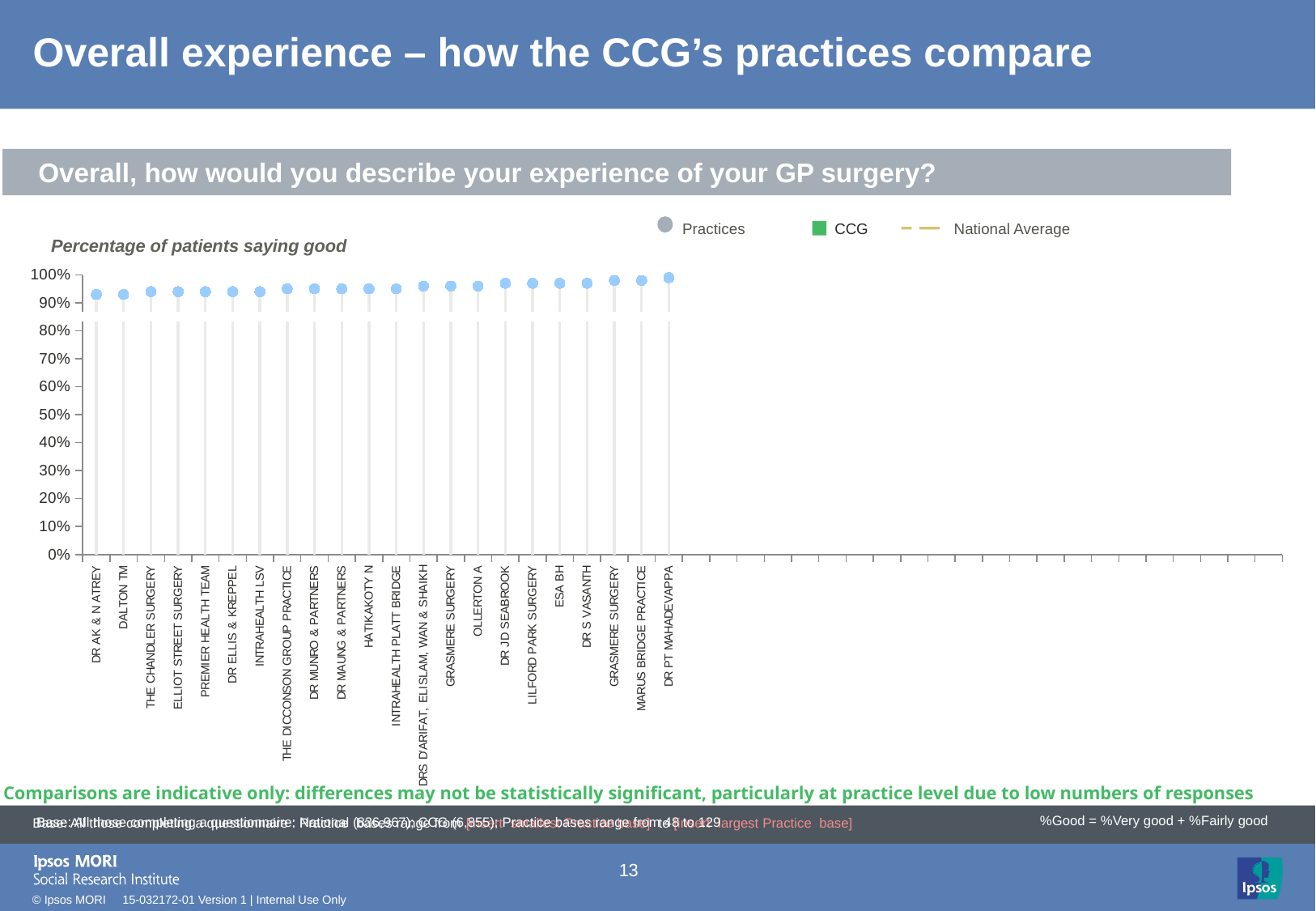
Is the value for DR AK & N ATREY greater or less than 90%? greater What is the title printed above the chart's y axis? Percentage of patients saying good Is the value for DR PT MAHADEVAPPA greater or less than 90%? greater Which has the larger value, DR PT MAHADEVAPPA or DR AK & N ATREY? DR PT MAHADEVAPPA How many entries does the chart legend list? 3 Is the value for ELLIOT STREET SURGERY greater or less than 80%? greater Which has the larger value, MARUS BRIDGE PRACTICE or THE CHANDLER SURGERY? MARUS BRIDGE PRACTICE Which practice has the highest percentage of patients saying good? DR PT MAHADEVAPPA What colour is the CCG marker in the legend? green Do the plotted values rise or fall moving from left to right along the x axis? rise What kind of chart is used to show the percentage of patients saying good? dot plot How many practices are plotted on the chart? 22